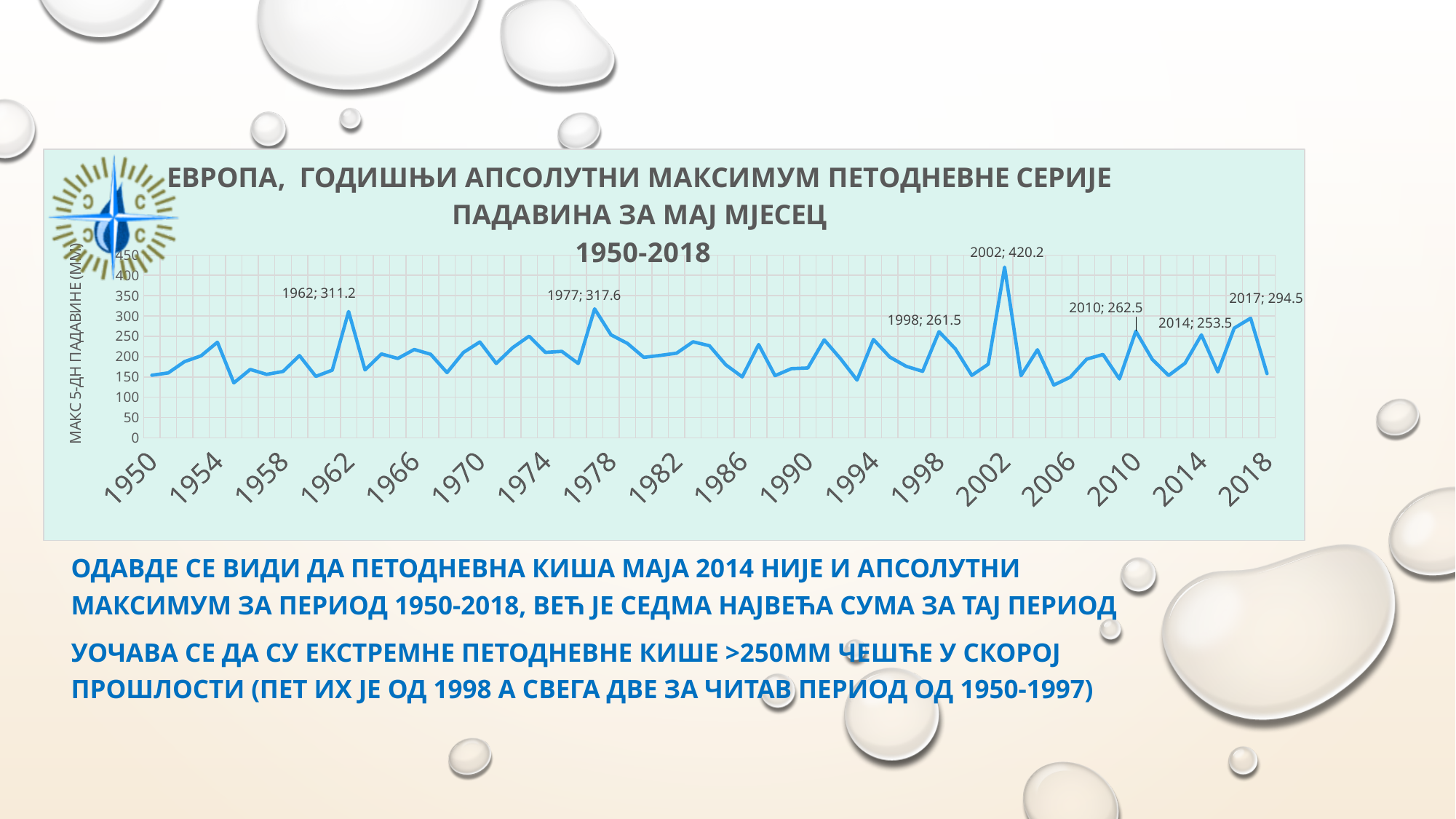
What is the difference between the labelled values for 2017 and 2014? 41 Which year has the highest value in the chart? 2002 What is the value labelled for the year 2017? 294.5 What is the value labelled for the year 1977? 317.6 What is the value labelled for the year 1962? 311.2 What is the difference between the labelled values for 2002 and 1977? 102.6 What type of chart is shown on the slide? line chart What is the value labelled for the year 2014? 253.5 Which year has the larger labelled value, 1977 or 1962? 1977 How many data points on the chart have printed data labels? 7 What is the value labelled for the year 2002? 420.2 Is the value for 1950 greater or less than 200? less